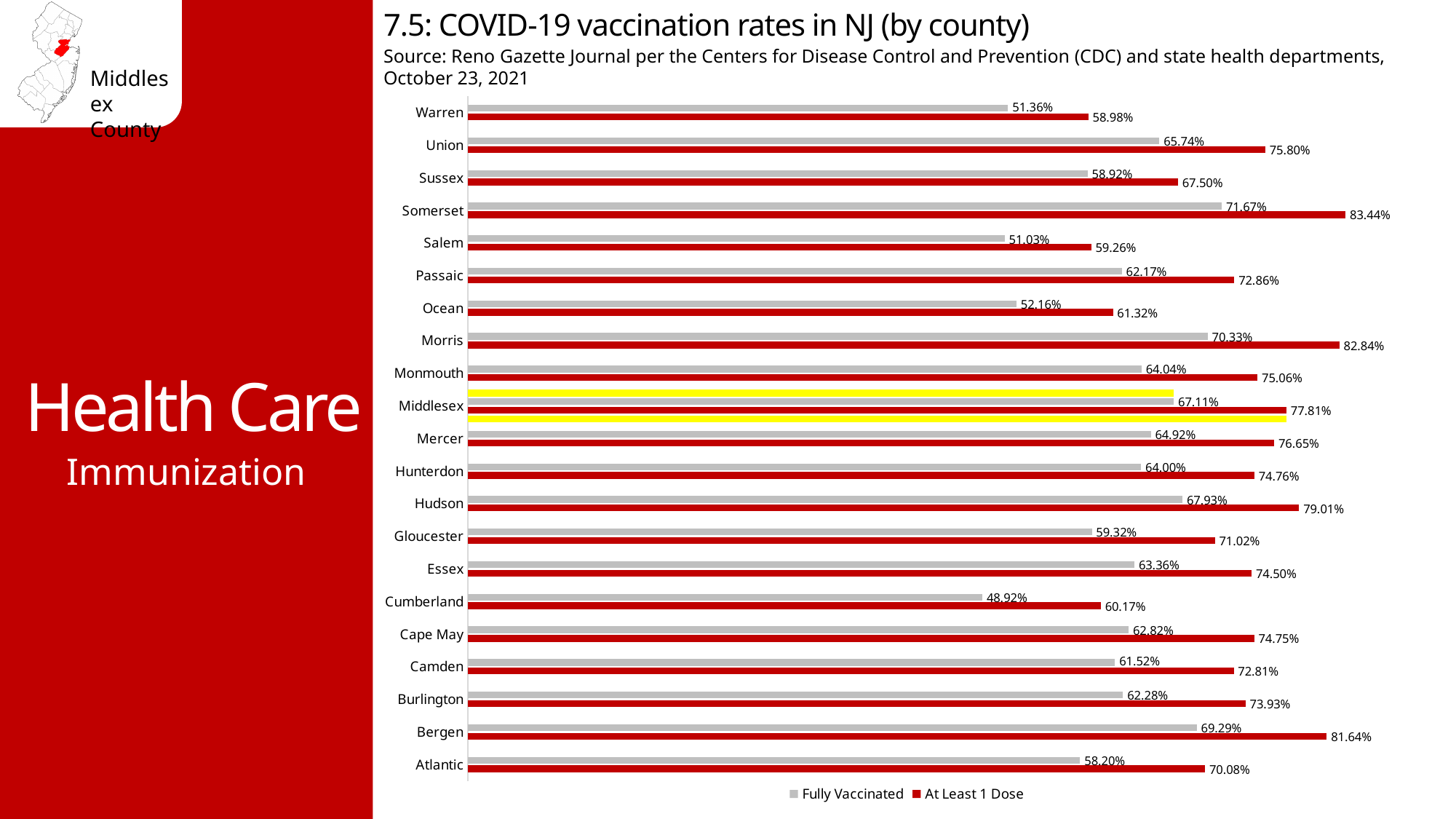
What is the At Least 1 Dose rate for Cumberland county? 60.17% How many series does the legend list? 2 Which county has a higher Fully Vaccinated rate, Bergen or Hudson? Bergen Which county has a higher At Least 1 Dose rate, Morris or Union? Morris What type of chart is shown on the slide? Bar chart Which county has the lowest At Least 1 Dose rate? Warren What is the Fully Vaccinated rate for Middlesex county? 67.11% What is the At Least 1 Dose rate for Somerset county? 83.44% Which county has the lowest Fully Vaccinated rate? Cumberland What is the difference between the At Least 1 Dose rate and the Fully Vaccinated rate for Middlesex county? 10.70 percentage points Which county has the highest Fully Vaccinated rate? Somerset How many counties are shown in the chart? 21